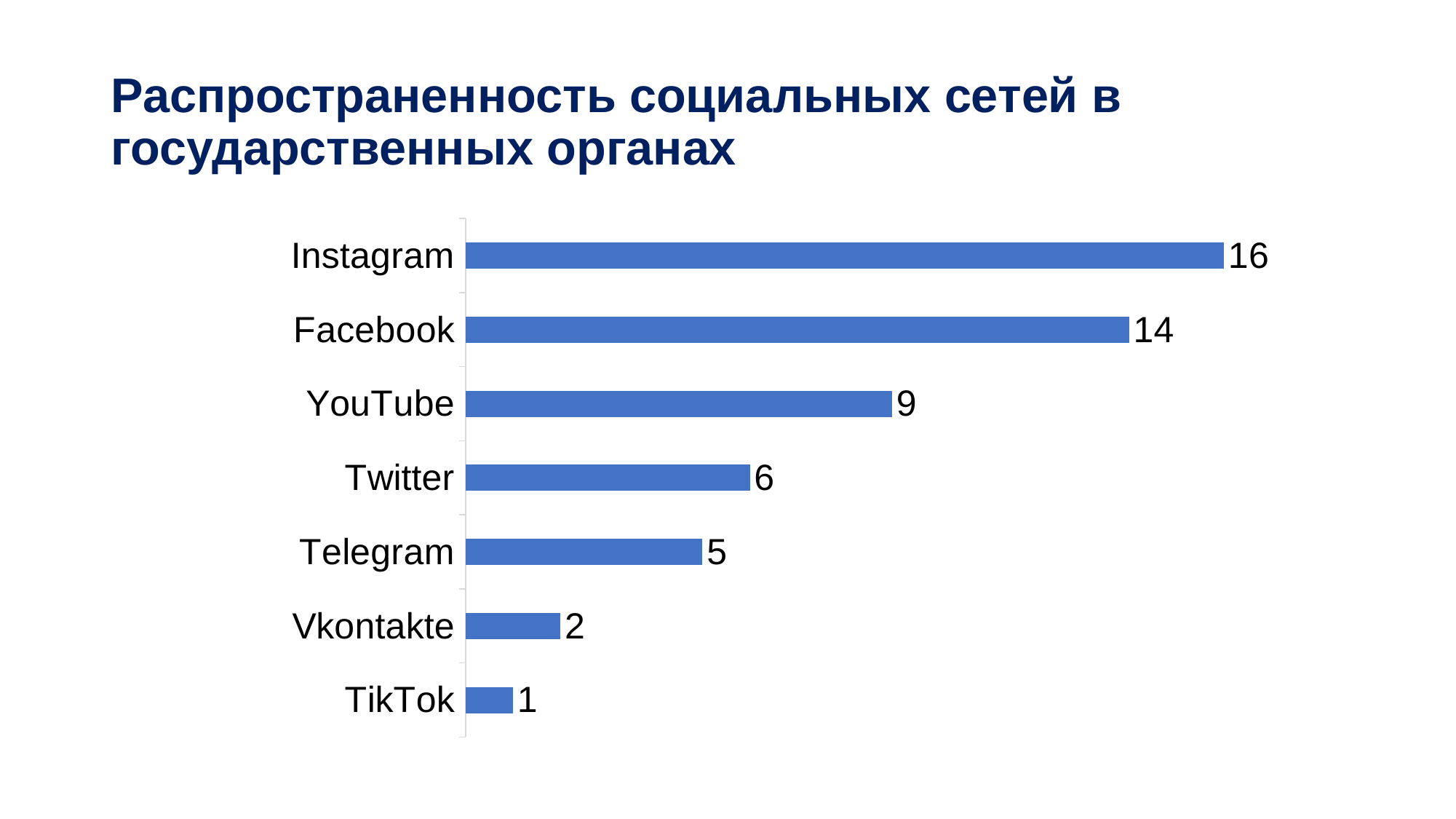
What is the value for Telegram? 5 What is the difference between the values for Instagram and Facebook? 2 What is the title of the slide? Распространенность социальных сетей в государственных органах What is the value for YouTube? 9 Which has a larger value, Vkontakte or TikTok? Vkontakte What is the difference between the values for YouTube and Twitter? 3 What kind of chart is shown on the slide? Bar chart Which social network has the highest value? Instagram Which social network has the lowest value? TikTok What is the value for Instagram? 16 Which has a larger value, Twitter or Telegram? Twitter How many social networks are shown in the chart? 7